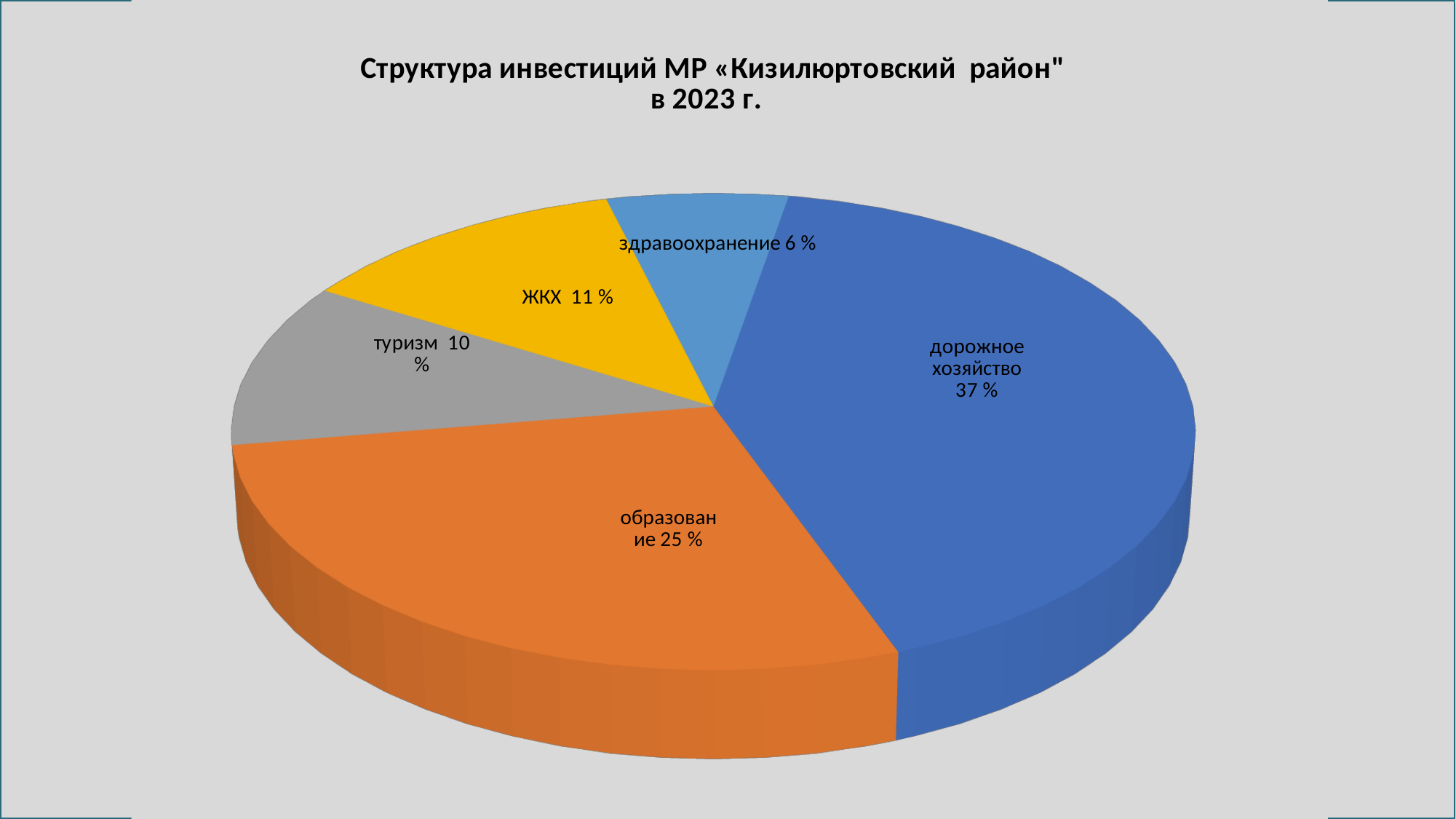
What share of investments does ЖКХ account for? 11 % What is the difference in percentage points between дорожное хозяйство and образование? 12 What share of investments does туризм account for? 10 % Which category has the largest share of investments? дорожное хозяйство How many categories are shown in the pie chart? 5 Which has a larger share, ЖКХ or туризм? ЖКХ Which category has the smallest share of investments? здравоохранение What share of investments does дорожное хозяйство account for? 37 % What share of investments does здравоохранение account for? 6 % What share of investments does образование account for? 25 % What type of chart is shown on the slide? pie chart What year does the chart title refer to? 2023